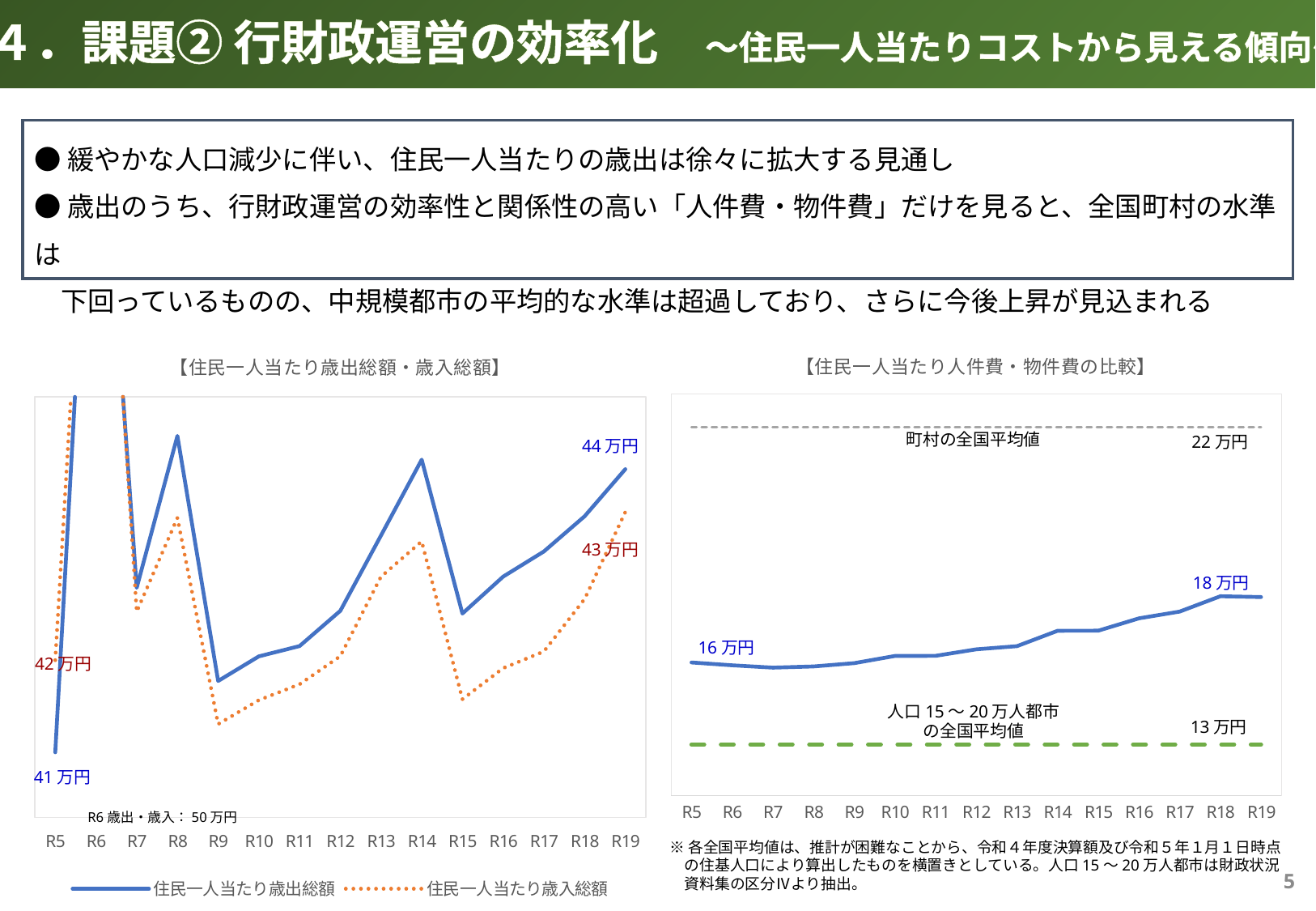
In the left chart 【住民一人当たり歳出総額・歳入総額】, what value is noted for R6 歳出・歳入? 50万円 In the left chart 【住民一人当たり歳出総額・歳入総額】, what is the value of 住民一人当たり歳入総額 at R19? 43万円 In the left chart 【住民一人当たり歳出総額・歳入総額】, which series is larger at R19, 歳出総額 or 歳入総額? 歳出総額 In the left chart 【住民一人当たり歳出総額・歳入総額】, how many series does the legend list? 2 In the left chart 【住民一人当たり歳出総額・歳入総額】, how many years are shown on the x axis? 15 In the right chart 【住民一人当たり人件費・物件費の比較】, what is the value at R5? 16万円 In the right chart 【住民一人当たり人件費・物件費の比較】, what is the difference between 町村の全国平均値 and 人口15～20万人都市の全国平均値? 9万円 In the right chart 【住民一人当たり人件費・物件費の比較】, what is the value of 町村の全国平均値? 22万円 What kind of chart is the left chart titled 【住民一人当たり歳出総額・歳入総額】? line chart In the left chart 【住民一人当たり歳出総額・歳入総額】, what is the value of 住民一人当たり歳出総額 at R5? 41万円 In the left chart 【住民一人当たり歳出総額・歳入総額】, what is the value of 住民一人当たり歳出総額 at R19? 44万円 In the right chart 【住民一人当たり人件費・物件費の比較】, does the blue line rise or fall from R5 to R19? rise